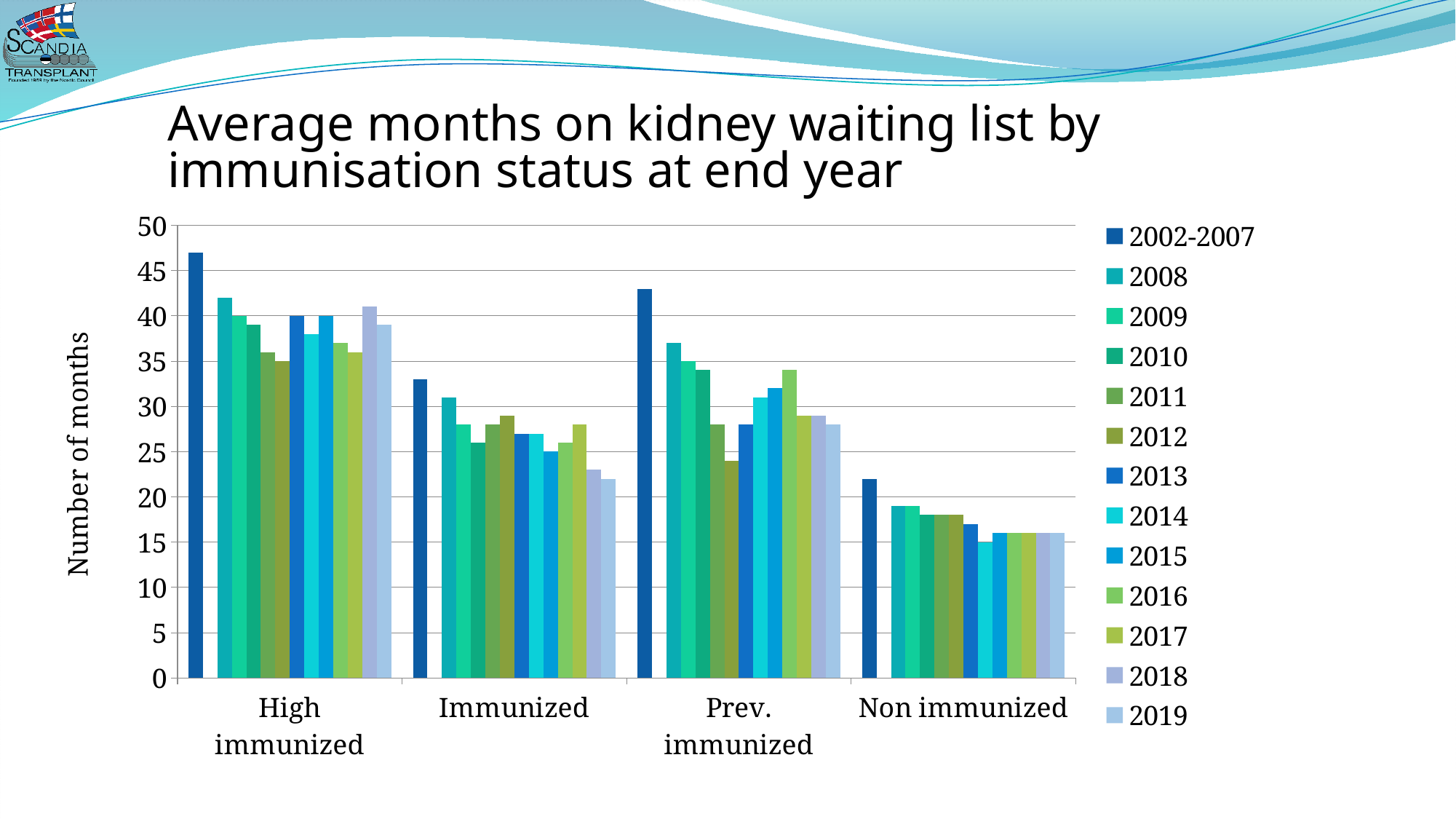
For High immunized, which is larger: the 2002-2007 value or the 2008 value? 2002-2007 Which category has the highest value for the 2002-2007 series? High immunized Is the 2019 value for Immunized greater or less than 25? less For the 2002-2007 series, which is larger: Immunized or Prev. immunized? Prev. immunized How many immunisation status categories are shown on the x axis? 4 Is the 2016 value for Prev. immunized greater or less than 30? greater What is the title of the y axis? Number of months Is the 2002-2007 value for High immunized greater or less than 45? greater How many series does the legend list? 13 Which category has the lowest value for the 2019 series? Non immunized What kind of chart is shown on the slide? bar chart